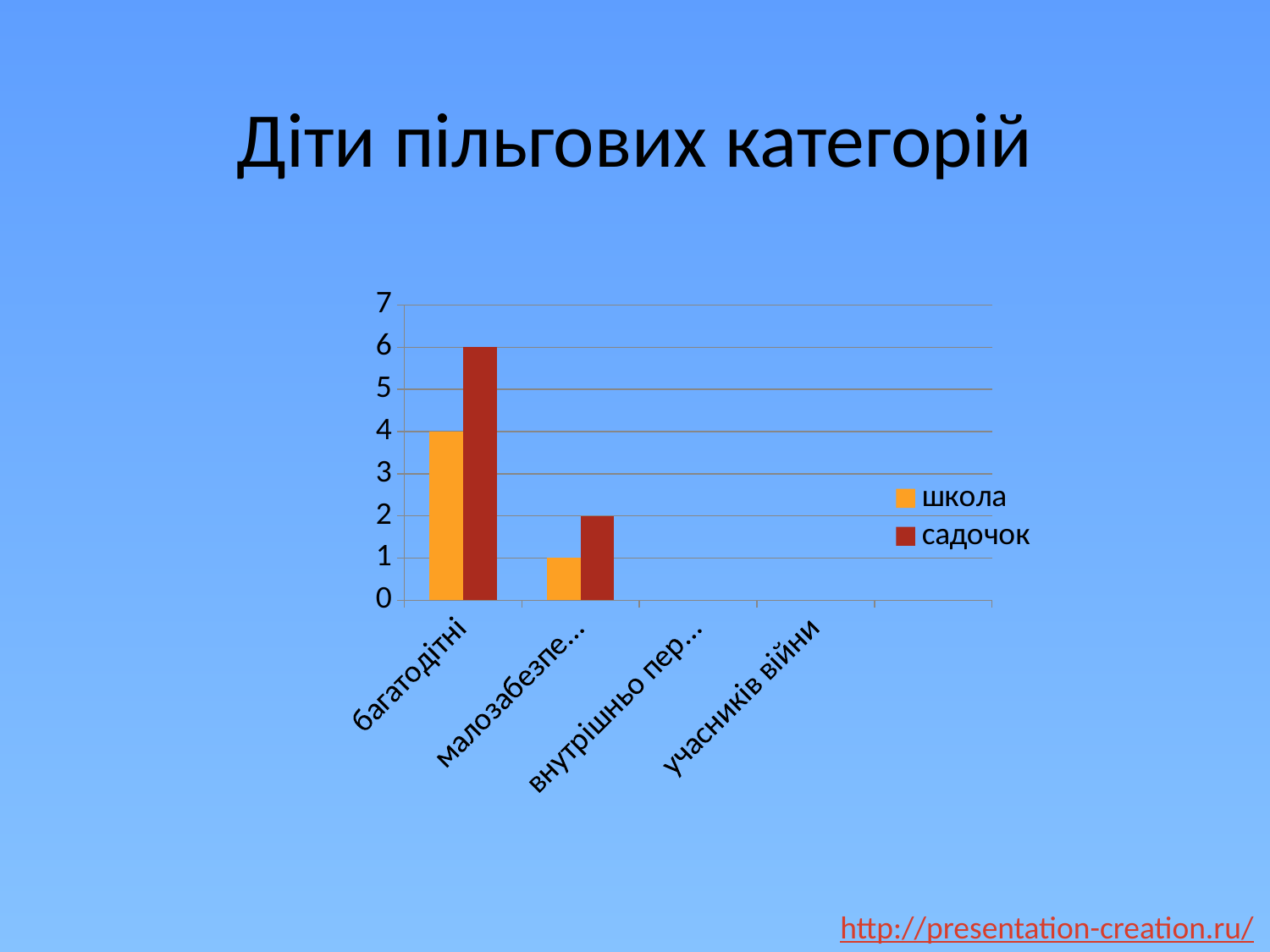
What is the value for садочок in the багатодітні category? 6 Is the value for садочок in the багатодітні category greater or less than 5? greater How many series does the legend list? 2 What is the value for садочок in the малозабезпе… category? 2 What type of chart is shown on the slide? bar chart What is the title of the slide? Діти пільгових категорій What is the value for школа in the малозабезпе… category? 1 What is the value for школа in the багатодітні category? 4 Which is larger in the багатодітні category, школа or садочок? садочок What is the difference between садочок and школа in the багатодітні category? 2 Which category has the highest value for садочок? багатодітні How many categories are shown on the x axis? 4